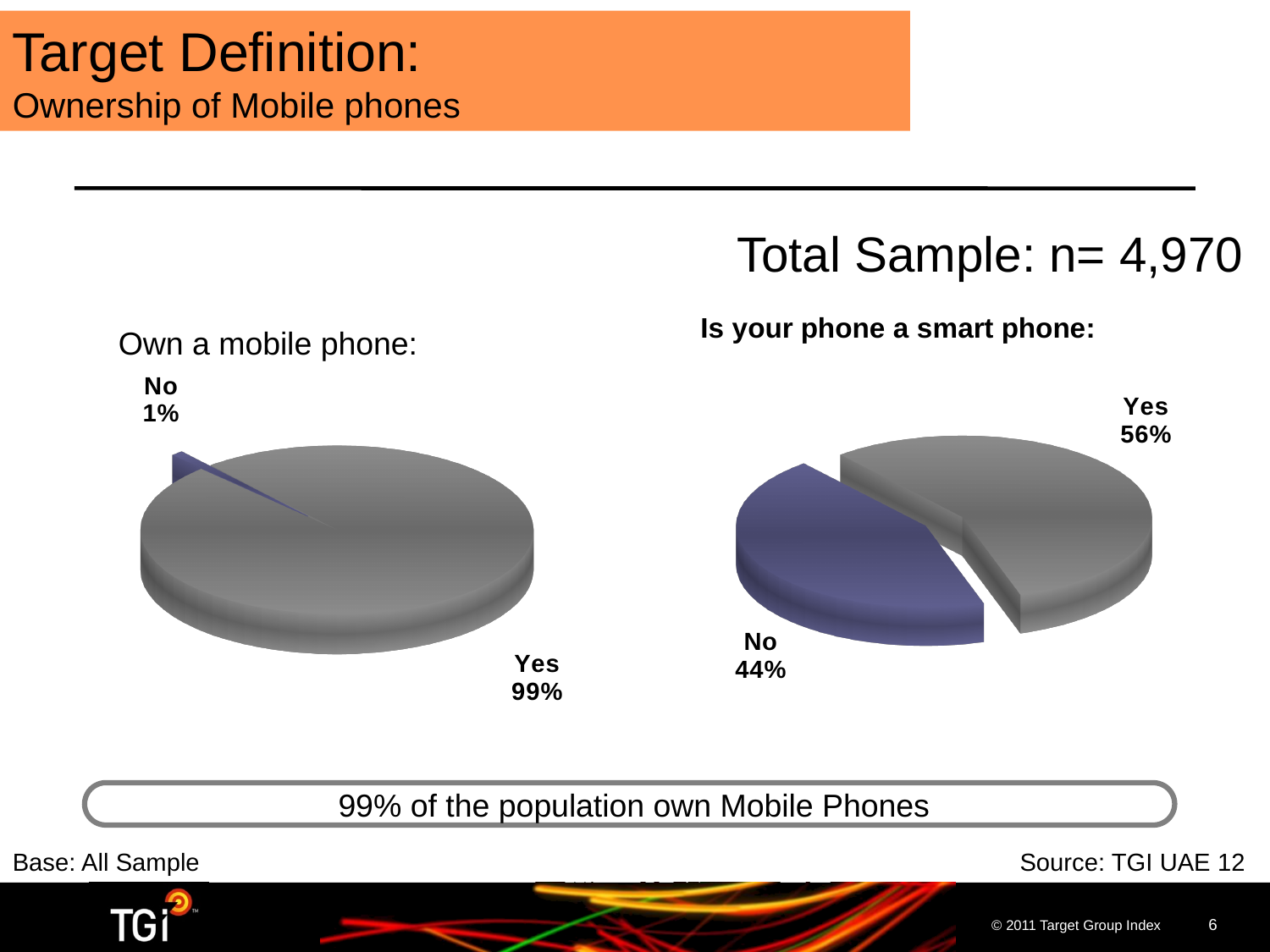
In the 'Own a mobile phone' chart, what percentage answered Yes? 99% In the 'Own a mobile phone' chart, what percentage answered No? 1% In the 'Is your phone a smart phone' chart, which slice is the largest? Yes In the 'Own a mobile phone' chart, which slice is the smallest? No In the 'Is your phone a smart phone' chart, what is the difference in percentage points between Yes and No? 12 In the 'Own a mobile phone' chart, what is the difference in percentage points between Yes and No? 98 What is the total sample size stated on the slide? n= 4,970 In the 'Is your phone a smart phone' chart, which is larger, Yes or No? Yes How many slices does the 'Is your phone a smart phone' chart have? 2 What type of chart is used for 'Own a mobile phone'? Pie chart In the 'Is your phone a smart phone' chart, what percentage answered No? 44% In the 'Is your phone a smart phone' chart, what percentage answered Yes? 56%